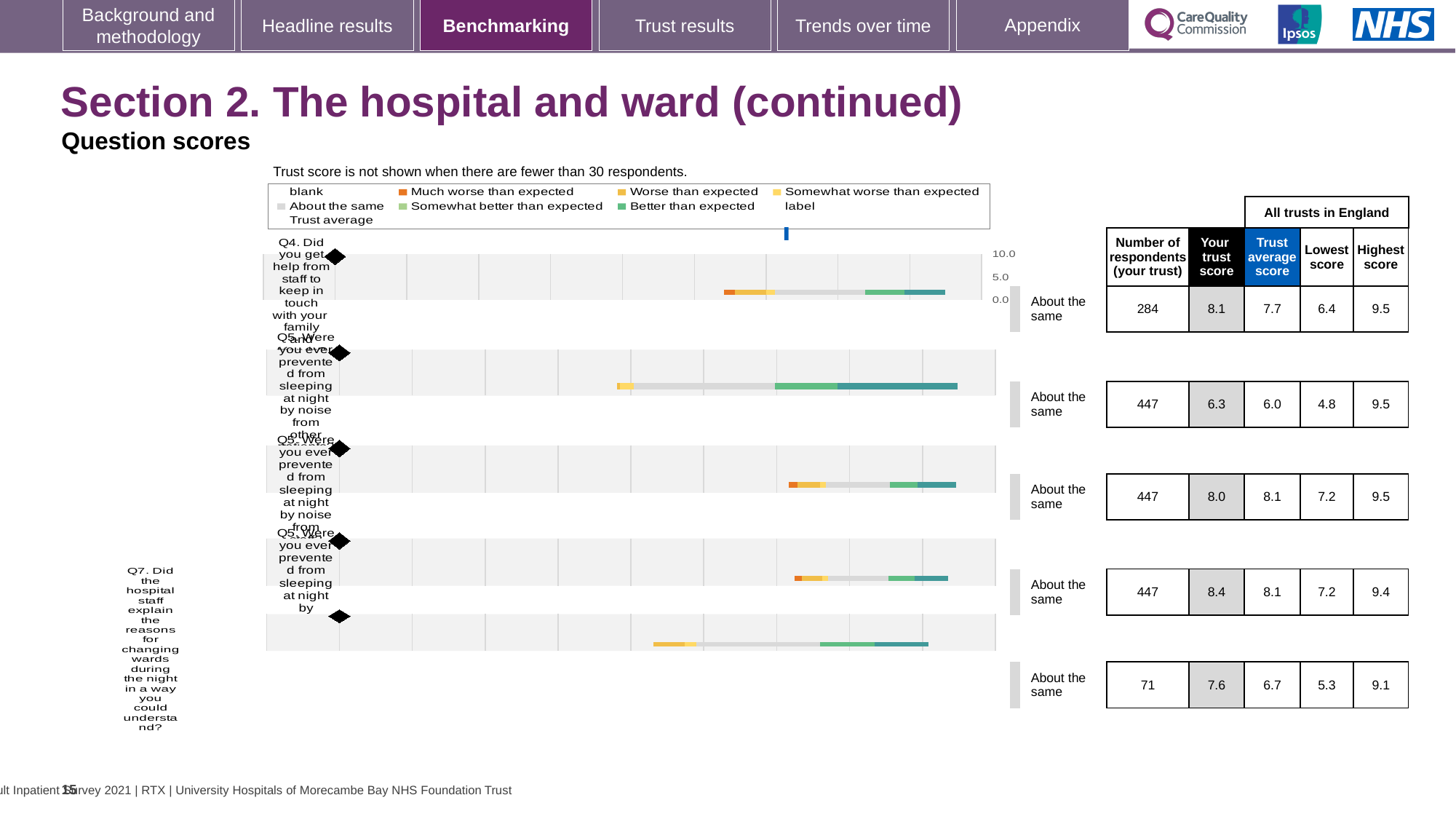
In the table, what is the 'Trust average score' for Q7 (explaining reasons for changing wards during the night)? 6.7 In the table, what is 'Your trust score' for Q4? 8.1 What is the difference between 'Your trust score' and the 'Trust average score' for Q4? 0.4 What is the smallest value in the 'Lowest score' column of the table? 4.8 According to the note above the chart, when is the trust score not shown? When there are fewer than 30 respondents What kind of chart is used to show the question scores on this slide? bar chart What is the highest value in the 'Your trust score' column of the table? 8.4 For Q7, which is larger: 'Your trust score' or the 'Trust average score'? Your trust score How many question rows (bars) are plotted in the chart? 5 In the table, how many respondents are listed for Q4 (help from staff to keep in touch with family and friends)? 284 What comparison label is shown beside every row of the chart? About the same In the table, how many respondents are listed for Q7? 71